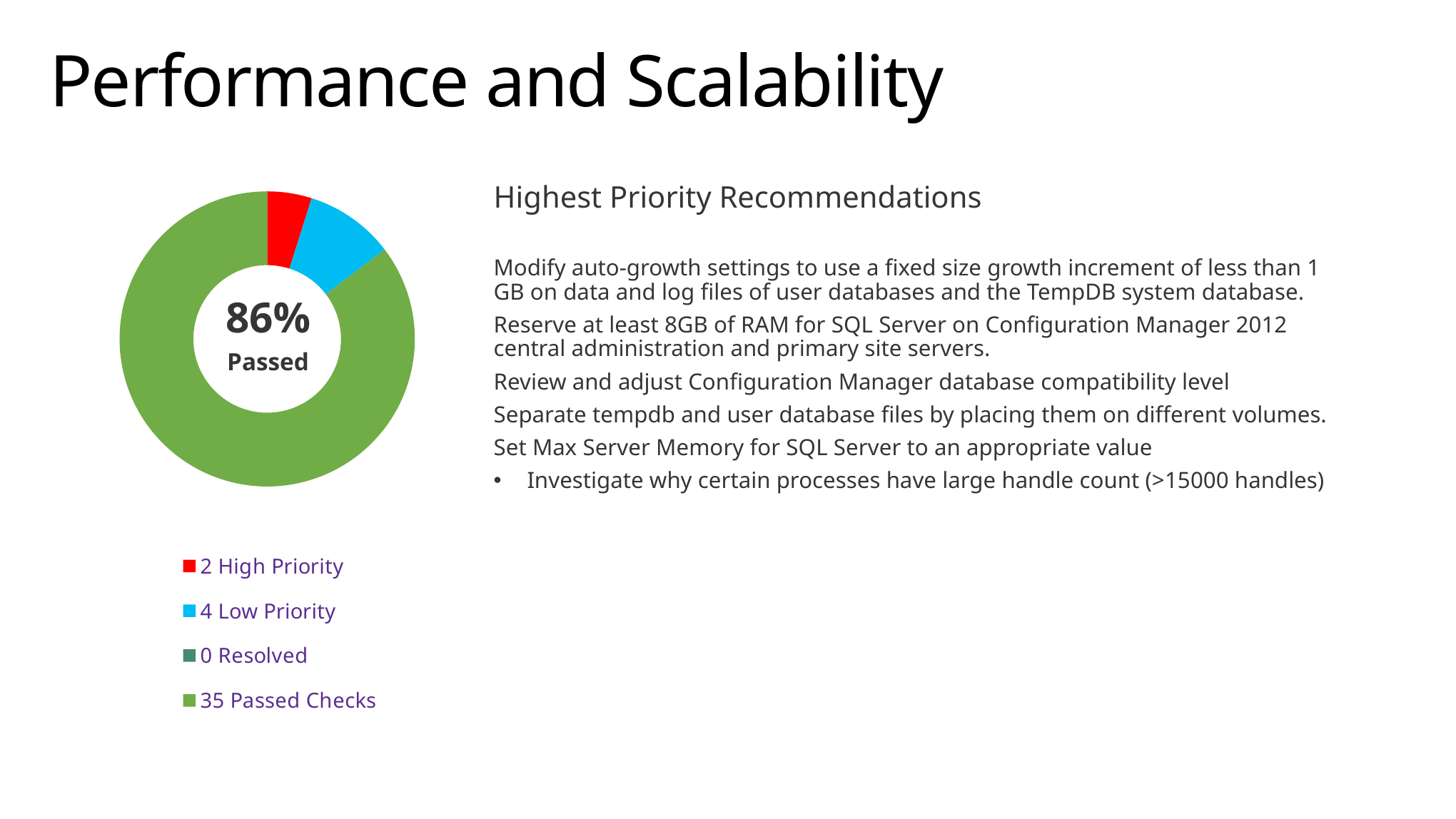
How many categories does the legend list? 4 What percentage of checks passed, according to the centre of the donut chart? 86% What kind of chart is shown on the slide? Donut chart What colour represents Low Priority in the chart? Blue How many Low Priority items does the legend show? 4 How many High Priority items does the legend show? 2 Which category has the smallest value in the chart? Resolved Which category has the largest value in the chart? Passed Checks What is the difference between the number of Low Priority items and High Priority items? 2 How many Passed Checks does the legend show? 35 Which is larger, the number of Low Priority items or the number of High Priority items? Low Priority How many Resolved items does the legend show? 0